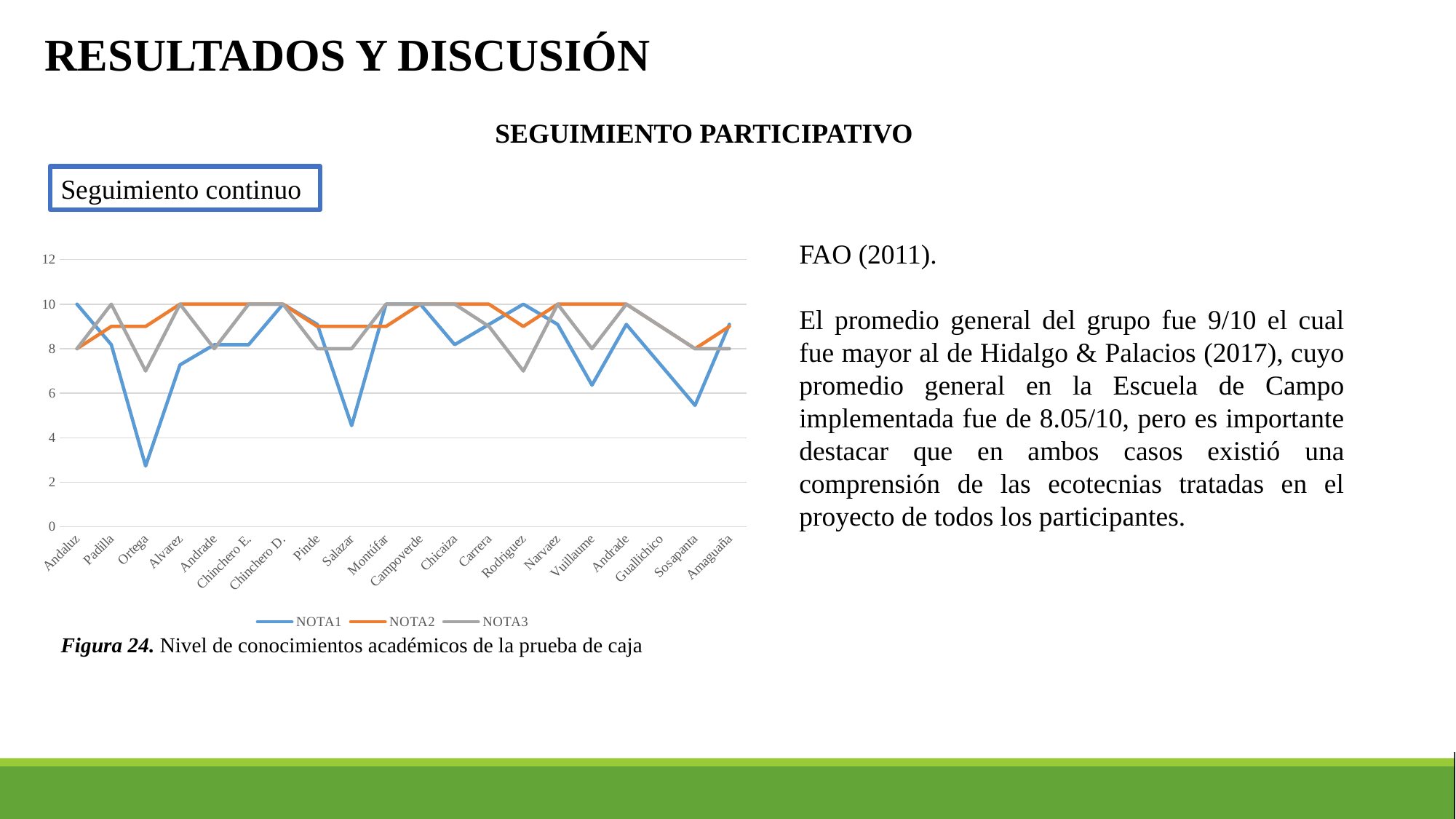
How many categories (names) are shown along the x axis of the chart? 20 Which category has the lowest NOTA1 value? Ortega Is the NOTA1 value for Salazar greater or less than 6? less What is the figure caption below the chart? Figura 24. Nivel de conocimientos académicos de la prueba de caja What are the names of the three series in the chart legend? NOTA1, NOTA2, NOTA3 What is the NOTA1 value for Andaluz? 10 Which is larger for Ortega, the NOTA1 value or the NOTA2 value? NOTA2 Is the NOTA3 value for Ortega greater or less than 8? less What kind of chart is shown on the slide? line chart Is the NOTA1 value for Sosapanta greater or less than 6? less How many series does the legend of the chart list? 3